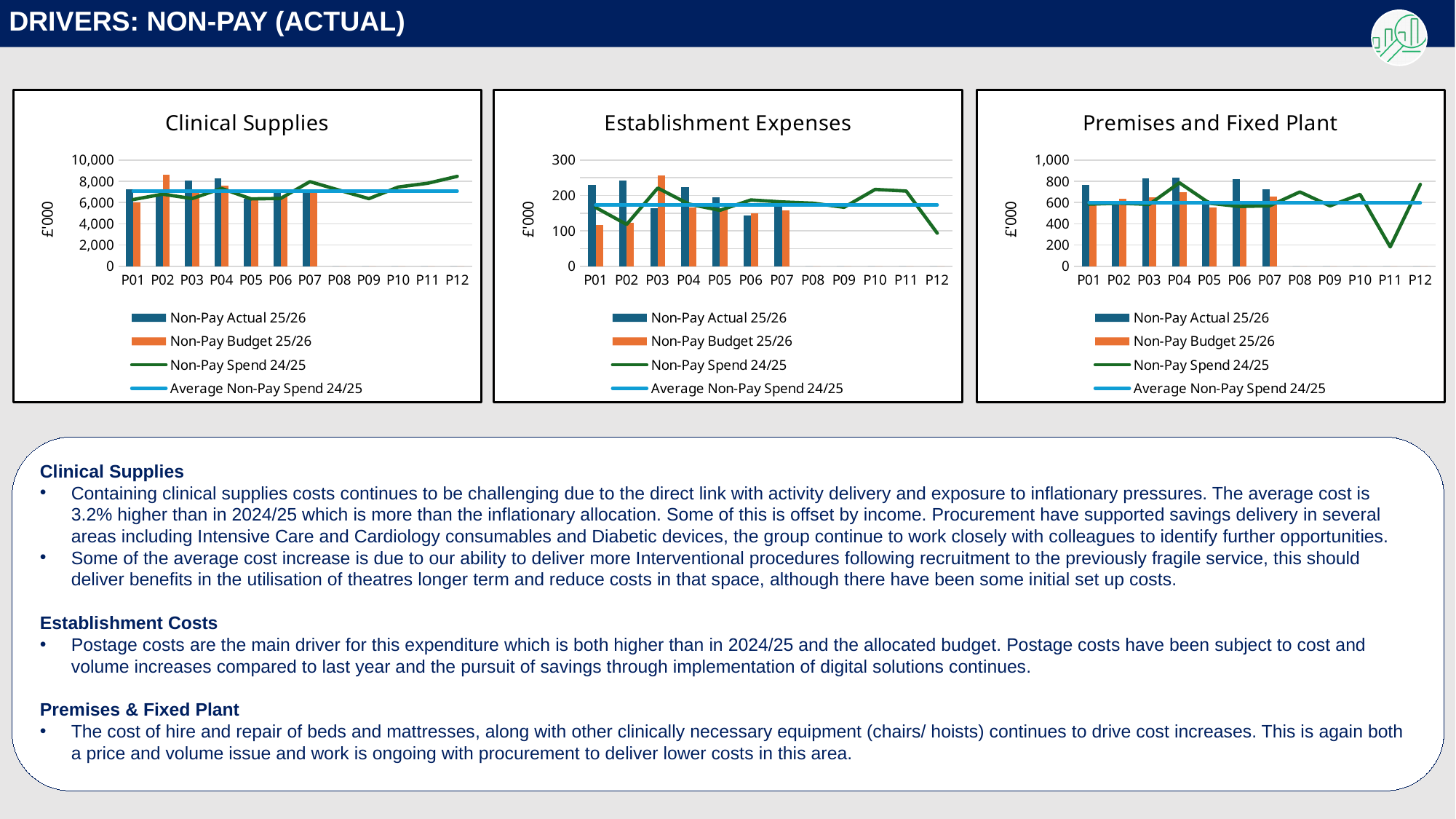
In the Clinical Supplies chart, which period has the highest Non-Pay Budget 25/26 bar? P02 In the Establishment Expenses chart, is the Non-Pay Budget 25/26 value for P01 greater or less than 200? less What kind of chart is the Premises and Fixed Plant chart? Combined bar and line chart How many series does the legend of the Clinical Supplies chart list? 4 In the Premises and Fixed Plant chart, which is larger at P01: Non-Pay Actual 25/26 or Non-Pay Budget 25/26? Non-Pay Actual 25/26 In the Establishment Expenses chart, which period has the highest Non-Pay Actual 25/26 bar? P02 In the Establishment Expenses chart, which period has the lowest Non-Pay Actual 25/26 bar? P06 How many periods are shown on the x axis of the Establishment Expenses chart? 12 In the Clinical Supplies chart, is the Non-Pay Budget 25/26 value for P02 greater or less than 8,000? greater In the Premises and Fixed Plant chart, is the Non-Pay Spend 24/25 value at P11 greater or less than 400? less What is the y-axis label on the Clinical Supplies chart? £'000